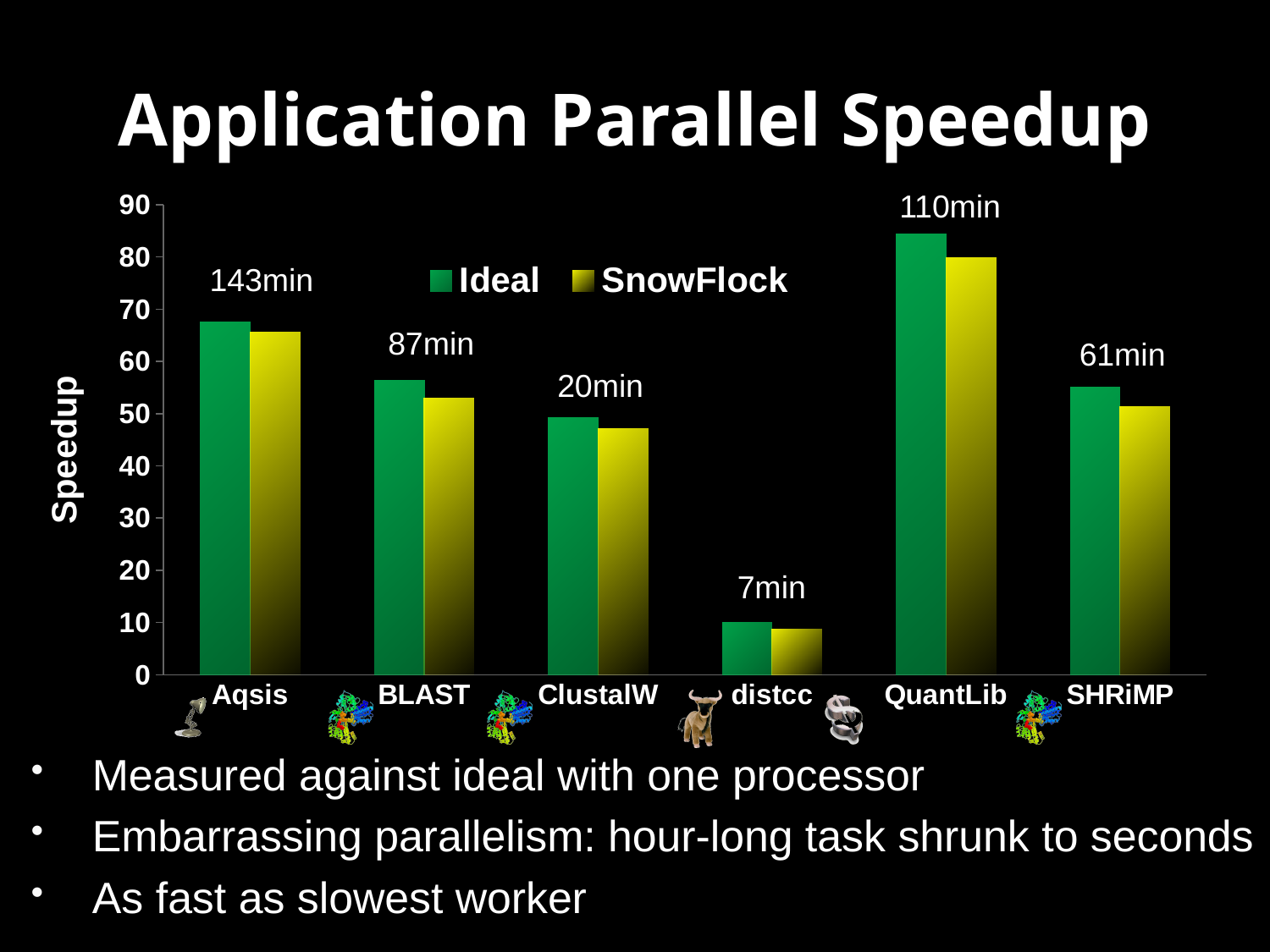
What is the label on the y axis? Speedup Which has a larger Ideal speedup, Aqsis or BLAST? Aqsis Is the Ideal speedup for QuantLib greater or less than 80? greater What is the title of the chart? Application Parallel Speedup Which application has the highest Ideal speedup? QuantLib Is the SnowFlock speedup for Aqsis greater or less than 60? greater How many applications (categories) are shown on the x axis? 6 Which application has the lowest SnowFlock speedup? distcc Is the SnowFlock speedup for distcc greater or less than 10? less How many series does the legend list? 2 What time annotation is printed above the distcc bars? 7min What kind of chart is shown on the slide? bar chart